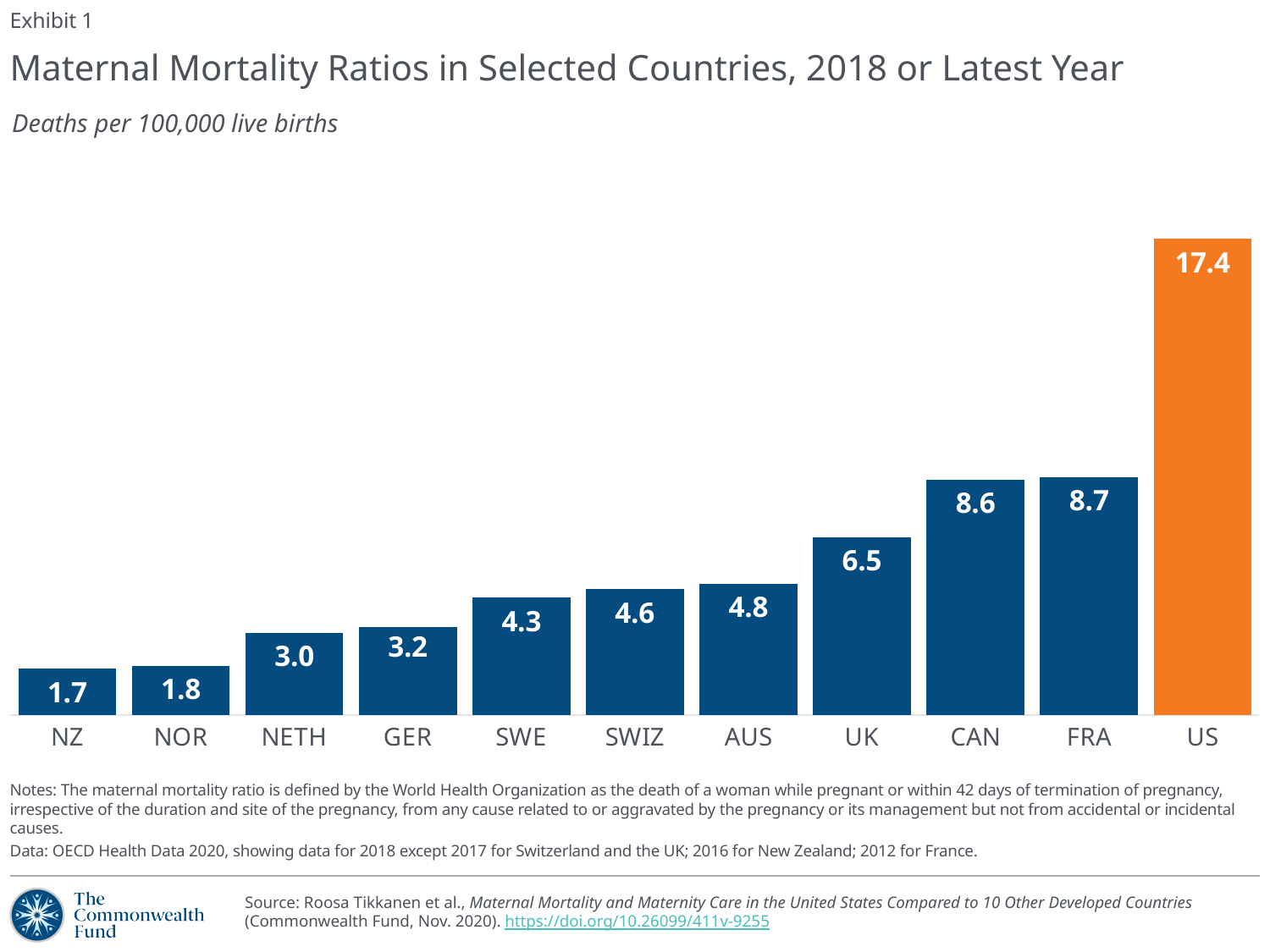
What is the value shown for SWE? 4.3 What is the difference between the values for the US and FRA? 8.7 Which country has the highest maternal mortality ratio on the chart? US What is the value shown for NETH? 3.0 What is the maternal mortality ratio shown for the US? 17.4 What is the difference between the values for UK and AUS? 1.7 Do the values rise or fall moving from left to right across the chart? Rise Which country has the lowest maternal mortality ratio on the chart? NZ What kind of chart is shown on the slide? Bar chart How many countries are shown on the chart? 11 Which has a higher value, CAN or UK? CAN Which bar is coloured orange rather than blue? US